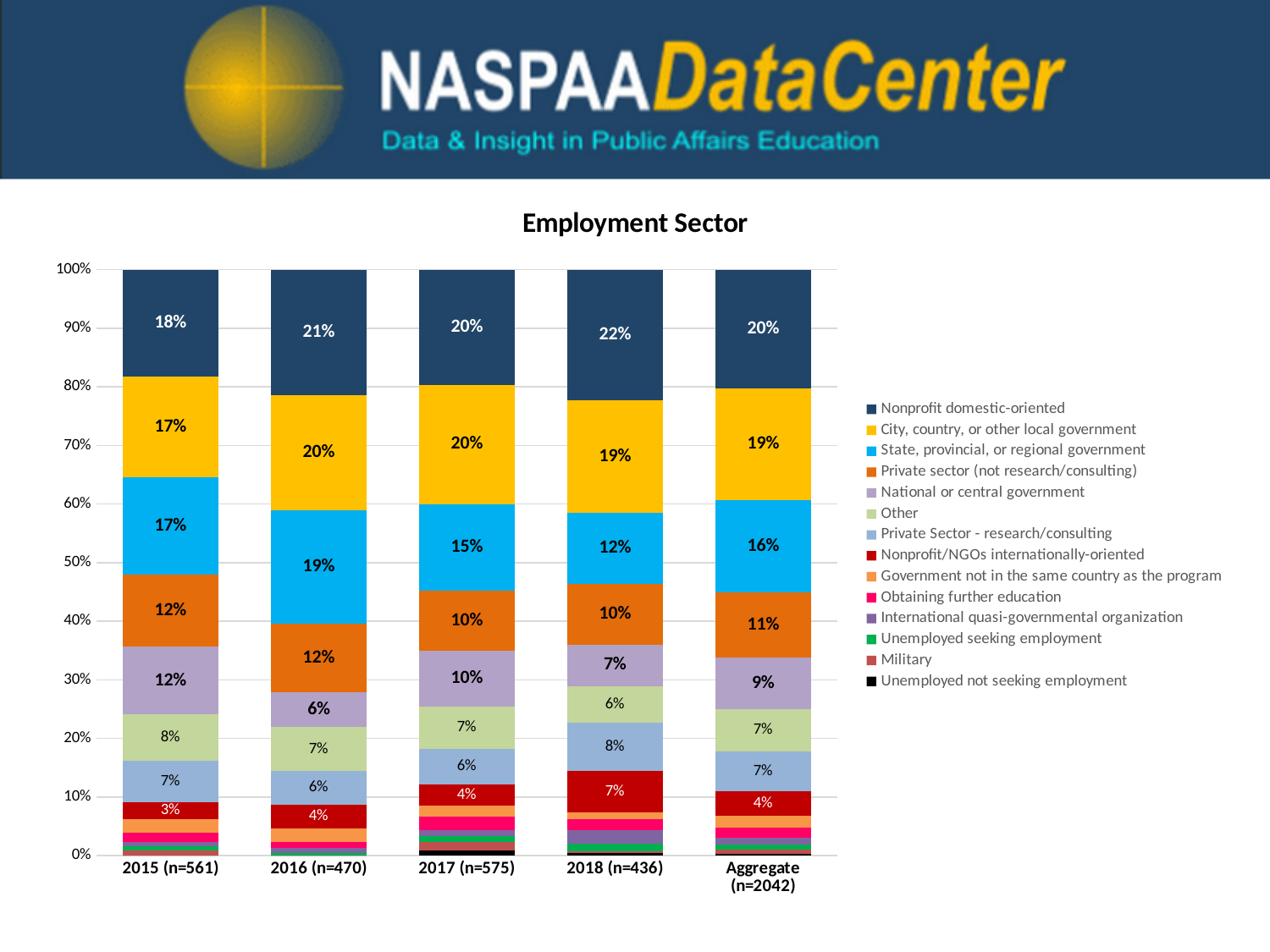
Does the value for State, provincial, or regional government rise or fall from 2016 (n=470) to 2018 (n=436)? fall What is the value for National or central government in the Aggregate (n=2042) bar? 9% What is the difference between the National or central government values for 2015 (n=561) and 2016 (n=470)? 6% Which is larger: the City, country, or other local government value in 2015 (n=561) or in 2017 (n=575)? 2017 (n=575) Which year has the lowest value for State, provincial, or regional government? 2018 (n=436) Which year has the highest value for Nonprofit/NGOs internationally-oriented? 2018 (n=436) What is the value for State, provincial, or regional government in 2016 (n=470)? 19% How many series does the legend list? 14 What is the title of the chart? Employment Sector What is the value for Nonprofit domestic-oriented in 2018 (n=436)? 22% What type of chart is shown on the slide? stacked bar chart How many bars (categories) are shown on the x axis? 5